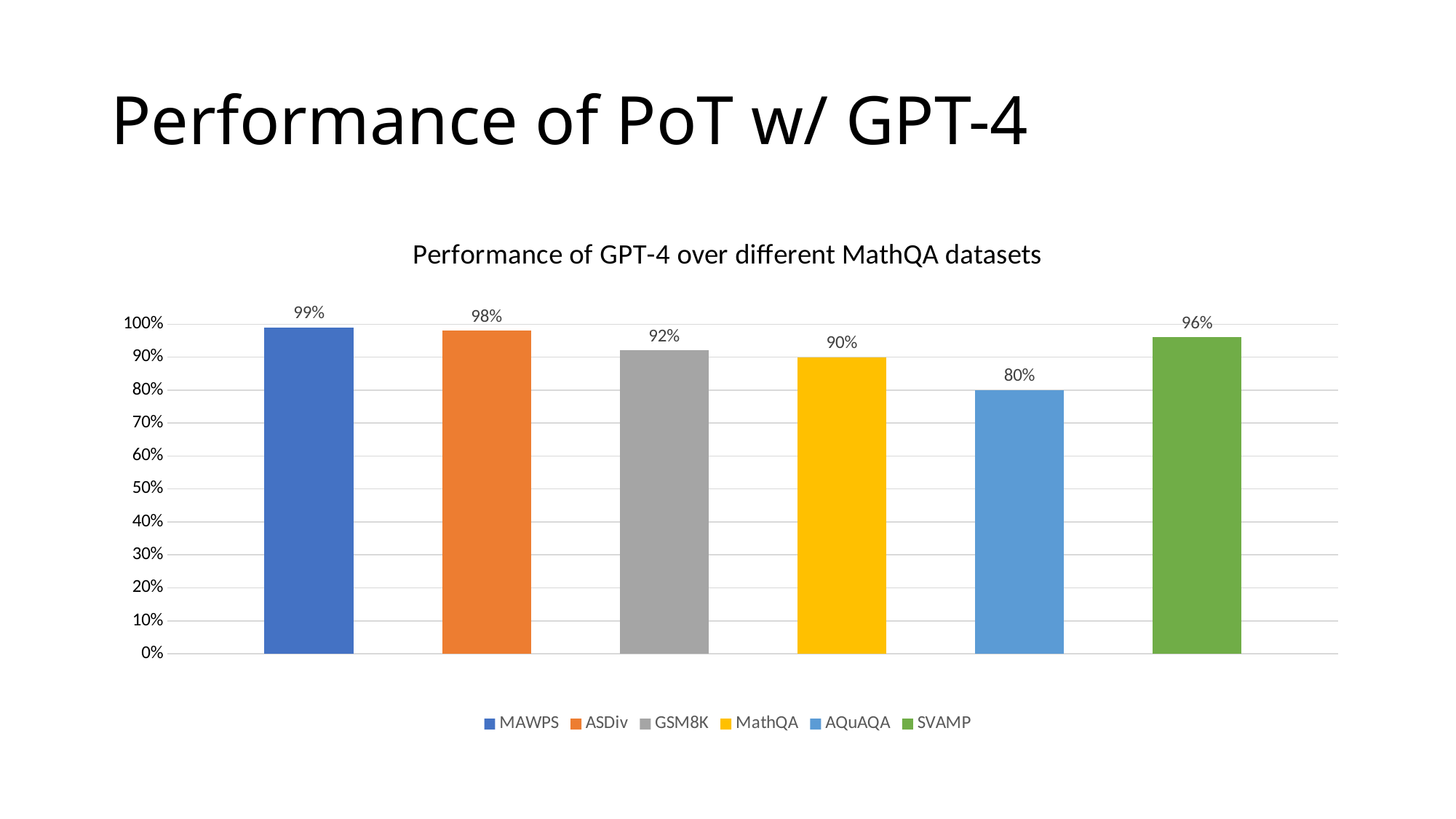
What is the value for GSM8K? 92% What is the value for MAWPS? 99% Which dataset has the highest value? MAWPS What is the value for AQuAQA? 80% What is the title of the chart? Performance of GPT-4 over different MathQA datasets How many bars are shown in the chart? 6 What kind of chart is shown on the slide? Bar chart What is the difference between the values for MAWPS and AQuAQA? 19% Which dataset has the lowest value? AQuAQA Which is larger, the value for GSM8K or the value for SVAMP? SVAMP What is the difference between the values for SVAMP and MathQA? 6% What is the value for SVAMP? 96%